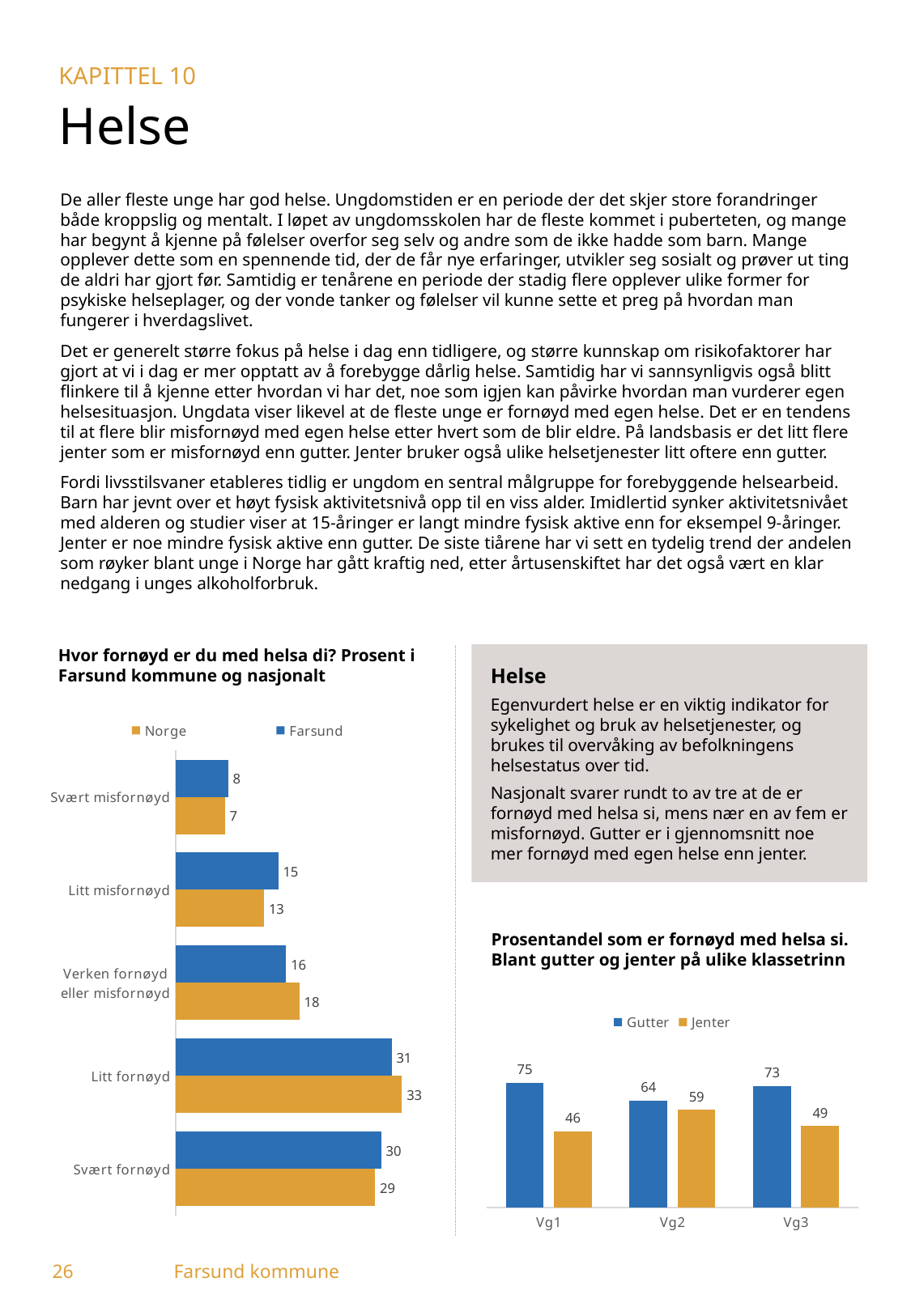
What kind of chart is 'Hvor fornøyd er du med helsa di?'? Bar chart In the chart 'Hvor fornøyd er du med helsa di?', how many categories are shown? 5 In the chart 'Prosentandel som er fornøyd med helsa si', what is the difference between Gutter and Jenter for Vg1? 29 In the chart 'Prosentandel som er fornøyd med helsa si', which class level has the highest Gutter value? Vg1 In the chart 'Hvor fornøyd er du med helsa di?', what is the Farsund value for 'Litt fornøyd'? 31 In the chart 'Prosentandel som er fornøyd med helsa si', what is the Jenter value for Vg2? 59 In the chart 'Hvor fornøyd er du med helsa di?', what is the difference between the Norge and Farsund values for 'Litt misfornøyd'? 2 In the chart 'Hvor fornøyd er du med helsa di?', what is the Norge value for 'Verken fornøyd eller misfornøyd'? 18 In the chart 'Hvor fornøyd er du med helsa di?', how many series does the legend list? 2 In the chart 'Prosentandel som er fornøyd med helsa si', which colour represents Jenter? Orange In the chart 'Hvor fornøyd er du med helsa di?', which category has the lowest Farsund value? Svært misfornøyd In the chart 'Hvor fornøyd er du med helsa di?', which category has the highest Norge value? Litt fornøyd